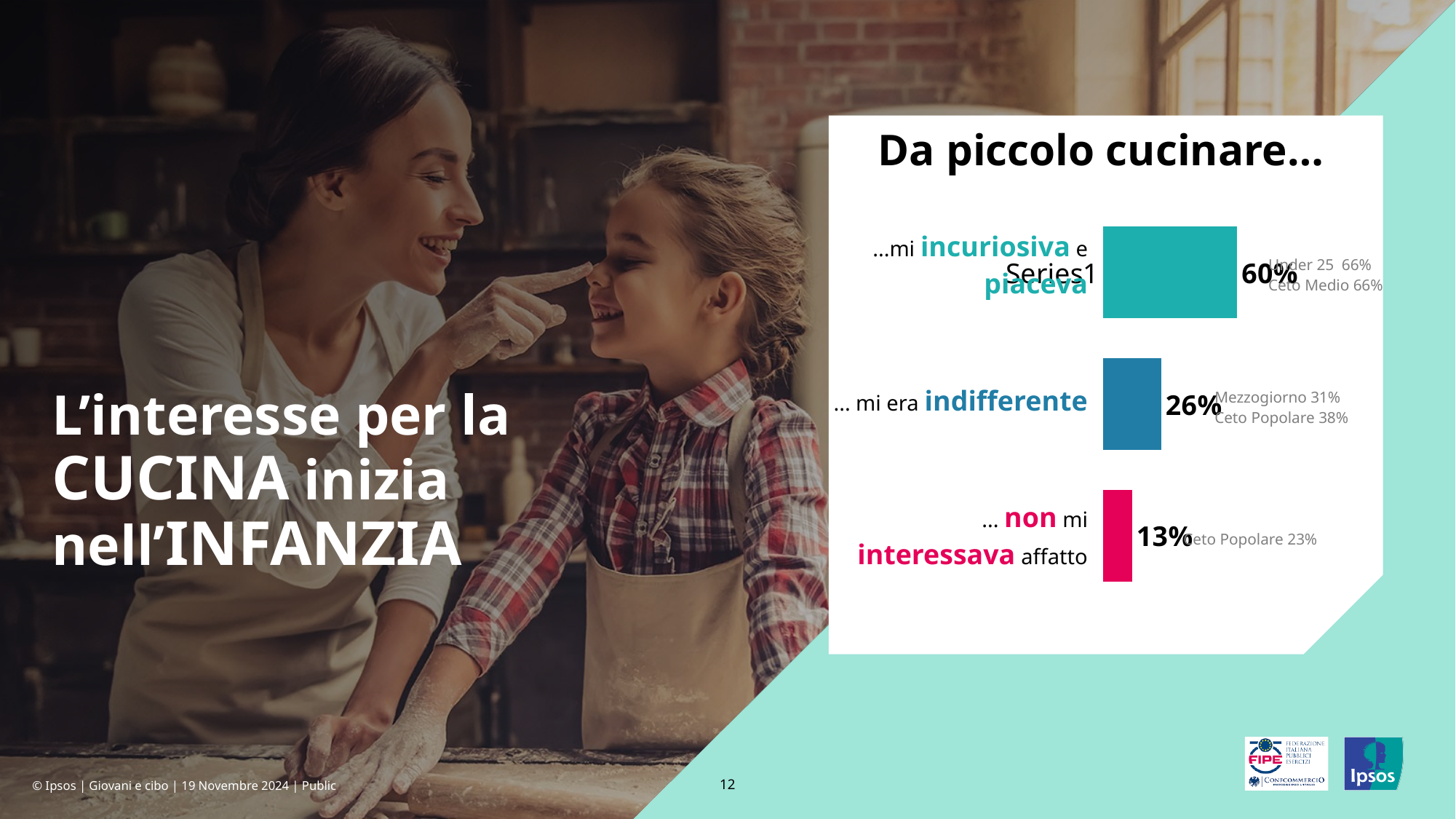
What colour is the bar for "... non mi interessava affatto"? Pink/magenta Which is larger: the value for "... mi era indifferente" or for "... non mi interessava affatto"? ... mi era indifferente Which category has the lowest value in the chart? ... non mi interessava affatto Which category has the highest value in the chart? ...mi incuriosiva e piaceva What is the value for "...mi incuriosiva e piaceva" in the chart? 60% What kind of chart is shown on the slide? Bar chart What is the difference between the values for "... mi era indifferente" and "... non mi interessava affatto"? 13% What is the value for "... non mi interessava affatto" in the chart? 13% How many categories are shown in the chart? 3 What is the value for "... mi era indifferente" in the chart? 26% What is the difference between the values for "...mi incuriosiva e piaceva" and "... mi era indifferente"? 34% What is the title of the chart? Da piccolo cucinare...